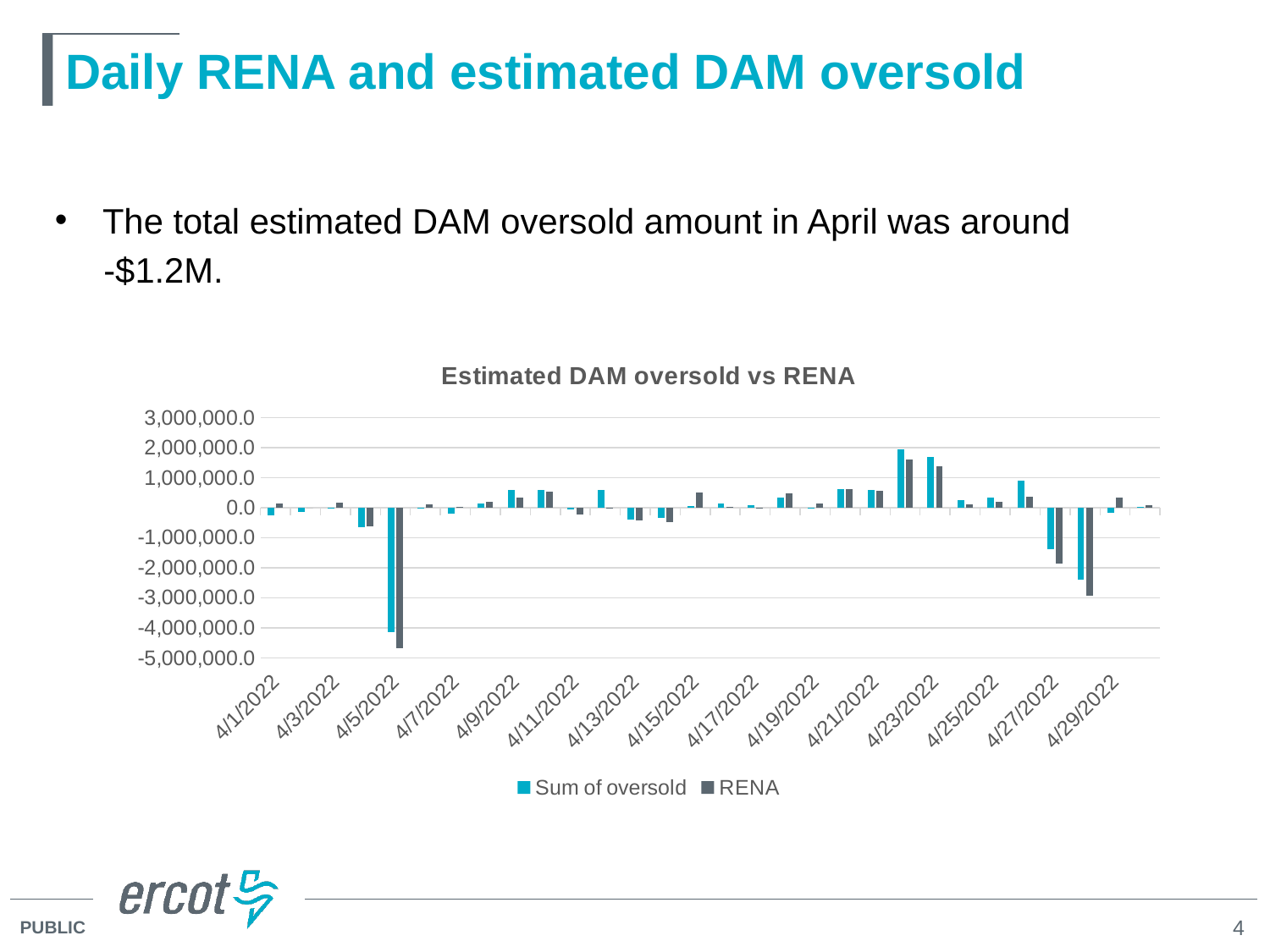
What is the title of the chart? Estimated DAM oversold vs RENA On 4/5/2022, which series has the lower value, Sum of oversold or RENA? RENA Which series has the lowest value anywhere on the chart? RENA Is the highest Sum of oversold value on the chart greater or less than 1,000,000.0? greater What kind of chart is shown on the slide? bar chart What is the first date label on the chart's horizontal axis? 4/1/2022 How many series does the chart's legend list? 2 Is the highest value on the chart greater or less than 3,000,000.0? less Is the RENA value for 4/5/2022 greater or less than -4,000,000.0? less What are the two series named in the chart's legend? Sum of oversold and RENA What is the lowest value shown on the chart's vertical axis? -5,000,000.0